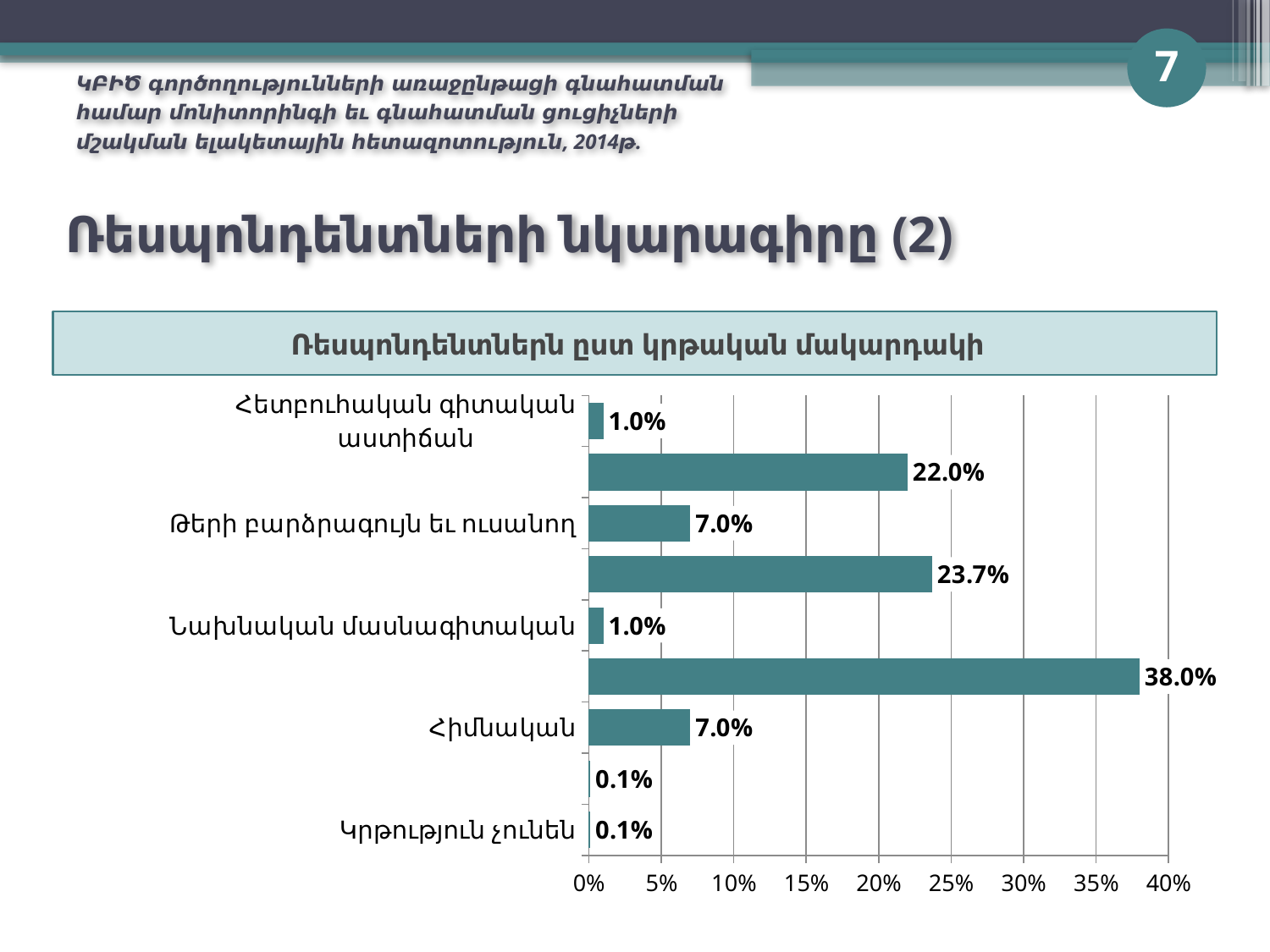
Which is larger, the value for Հիմնական or the value for Կրթություն չունեն? Հիմնական What is the value for Նախնական մասնագիտական? 1.0% What is the value for Կրթություն չունեն? 0.1% What is the value for Հետբուհական գիտական աստիճան? 1.0% How many bars are plotted on the chart? 9 What is the largest value shown on the chart? 38.0% What is the value for Հիմնական? 7.0% What is the title of the chart? Ռեսպոնդենտներն ըստ կրթական մակարդակի Is the value for Թերի բարձրագույն և ուսանող greater or less than 10%? less What is the value for Թերի բարձրագույն և ուսանող? 7.0% What type of chart is shown on the slide? bar chart What is the difference between the values for Հիմնական and Նախնական մասնագիտական? 6.0%